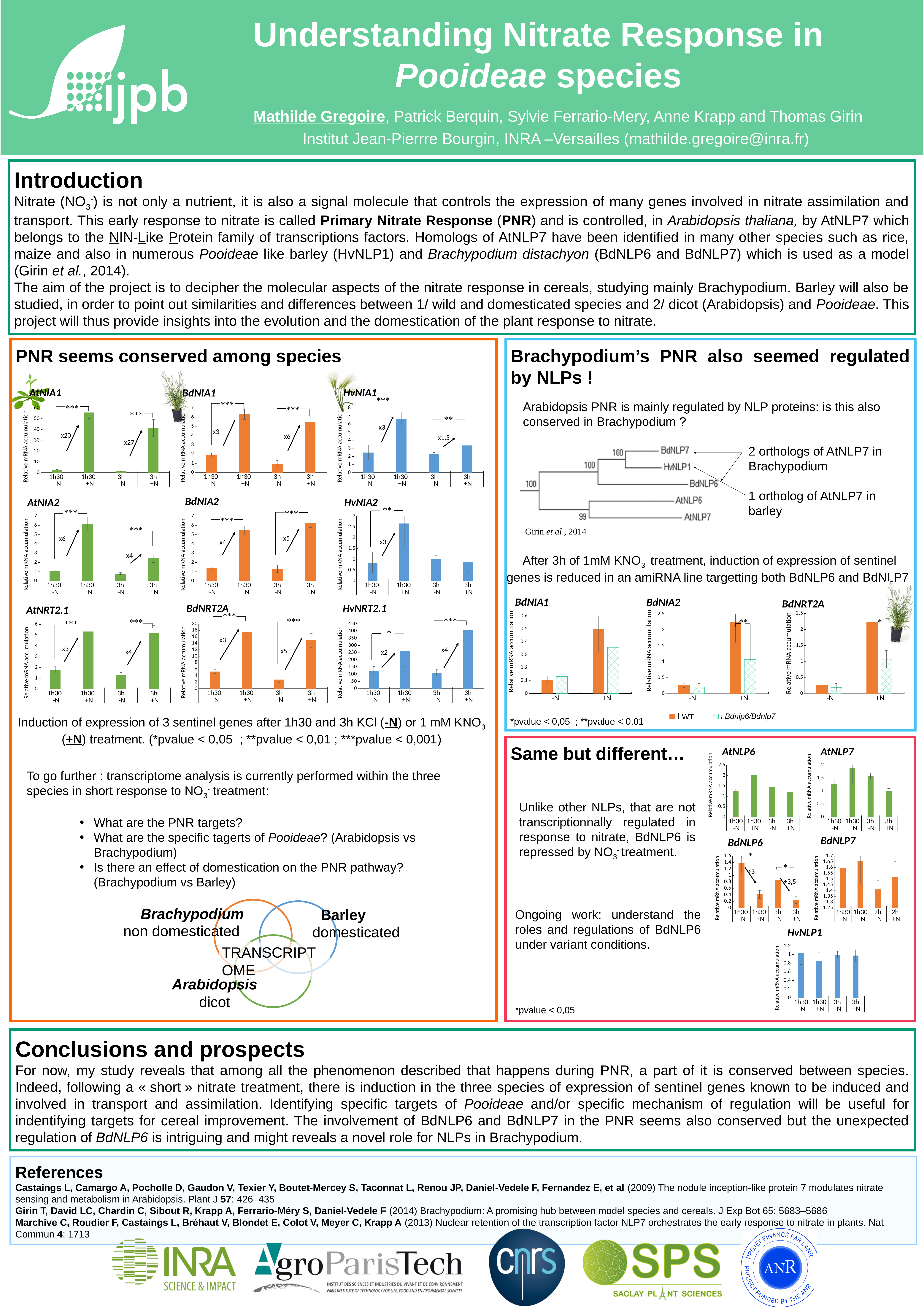
In the BdNIA2 chart of the 'Brachypodium's PNR also seemed regulated by NLPs!' panel, which series has the larger value at +N: WT or Bdnlp6/Bdnlp7? WT How many series does the legend list for the BdNIA1, BdNIA2 and BdNRT2A charts in the 'Brachypodium's PNR also seemed regulated by NLPs!' panel? 2 In the HvNRT2.1 chart of the 'PNR seems conserved among species' panel, is the value for 3h +N greater or less than 300? greater In the AtNIA1 chart of the 'PNR seems conserved among species' panel, what fold induction is annotated between 1h30 -N and 1h30 +N? x20 In the BdNRT2A chart of the 'PNR seems conserved among species' panel, which is larger: the value for 1h30 +N or the value for 3h -N? 1h30 +N How many categories are shown on the x axis of the AtNIA1 chart in the 'PNR seems conserved among species' panel? 4 In the BdNLP6 chart of the 'Same but different…' panel, is the value for 1h30 +N greater or less than 0.6? less In the AtNIA1 chart of the 'PNR seems conserved among species' panel, is the value for 1h30 +N greater or less than 40? greater How many separate charts are shown in the 'Same but different…' panel? 5 In the HvNRT2.1 chart of the 'PNR seems conserved among species' panel, which category has the highest value? 3h +N In the AtNIA1 chart of the 'PNR seems conserved among species' panel, which category has the highest value? 1h30 +N What kind of chart is the AtNIA1 chart in the 'PNR seems conserved among species' panel? bar chart